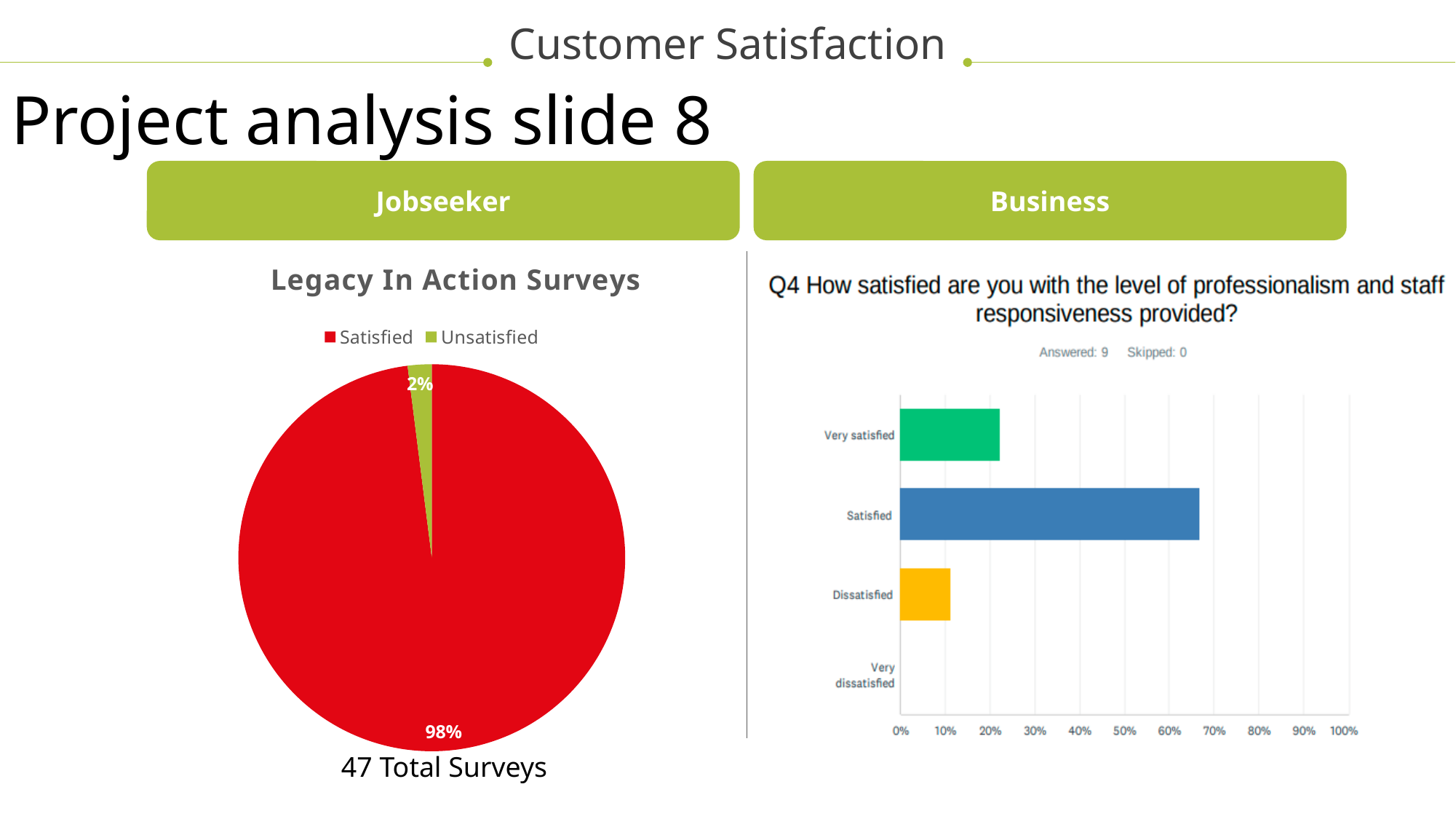
In the Legacy In Action Surveys pie chart, what share of responses is Satisfied? 98% In the Legacy In Action Surveys pie chart, which slice is the largest? Satisfied In the Legacy In Action Surveys pie chart, what share of responses is Unsatisfied? 2% In the Q4 chart on the right, is the value for Satisfied greater or less than 60%? greater In the Q4 chart on the right, is the value for Very satisfied greater or less than 30%? less In the Q4 chart on the right, which is larger, Very satisfied or Dissatisfied? Very satisfied In the Legacy In Action Surveys pie chart, what is the difference between the Satisfied and Unsatisfied shares? 96% What kind of chart is the Legacy In Action Surveys chart? Pie chart How many categories are listed on the vertical axis of the Q4 chart on the right? 4 How many entries does the legend of the Legacy In Action Surveys chart list? 2 In the Q4 chart on the right, which category has the longest bar? Satisfied What kind of chart is the Q4 chart on the right of the slide? Bar chart